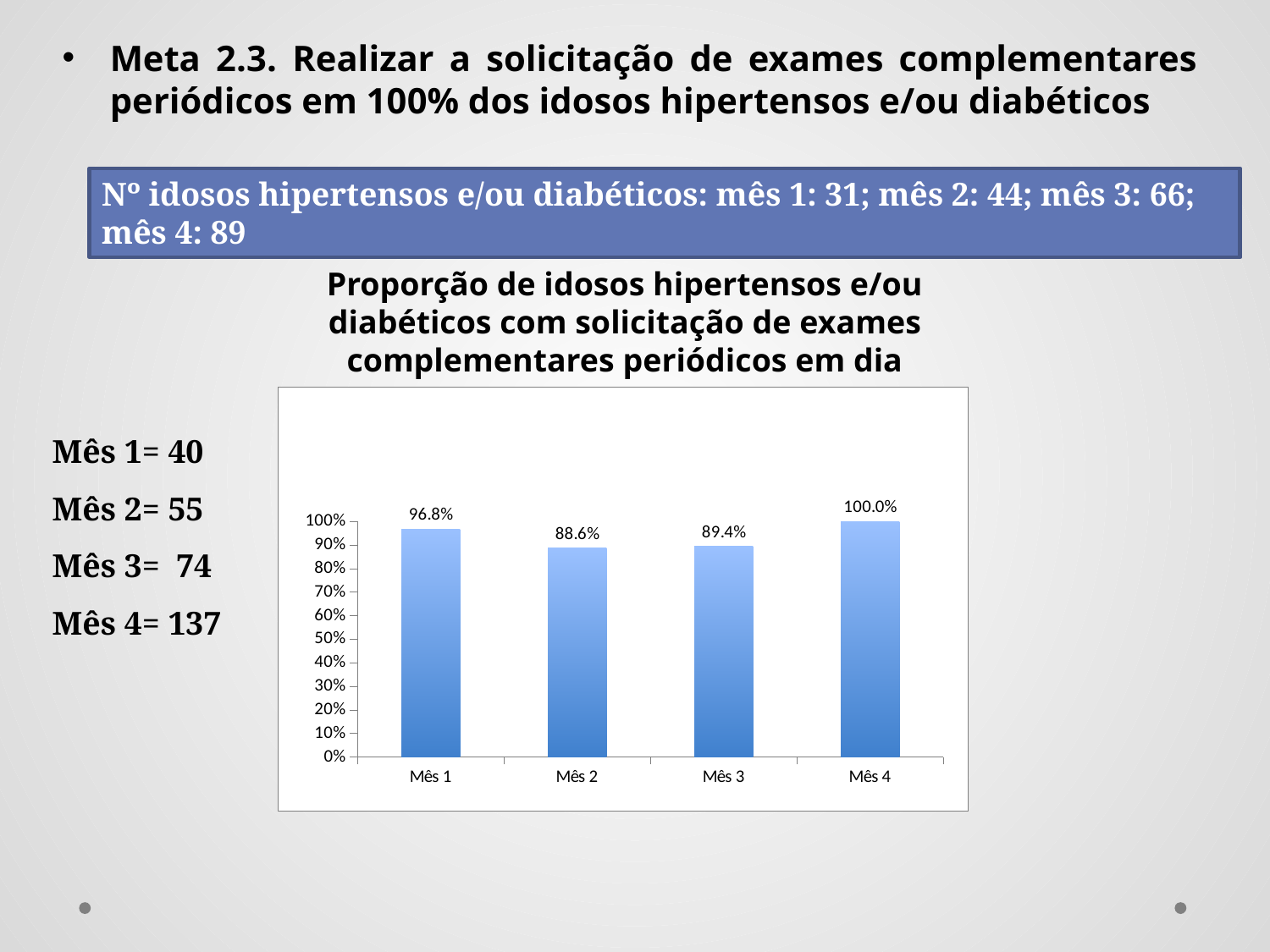
How many months are shown on the x axis? 4 Which is larger, the value for Mês 1 or the value for Mês 2? Mês 1 What is the title of the chart? Proporção de idosos hipertensos e/ou diabéticos com solicitação de exames complementares periódicos em dia What is the value for Mês 3? 89.4% What is the difference between the values for Mês 4 and Mês 1? 3.2% What is the value for Mês 4? 100.0% What kind of chart is shown? Bar chart Which month has the highest value? Mês 4 Which month has the lowest value? Mês 2 What is the difference between the values for Mês 1 and Mês 2? 8.2% What is the value for Mês 2? 88.6% What is the value for Mês 1? 96.8%